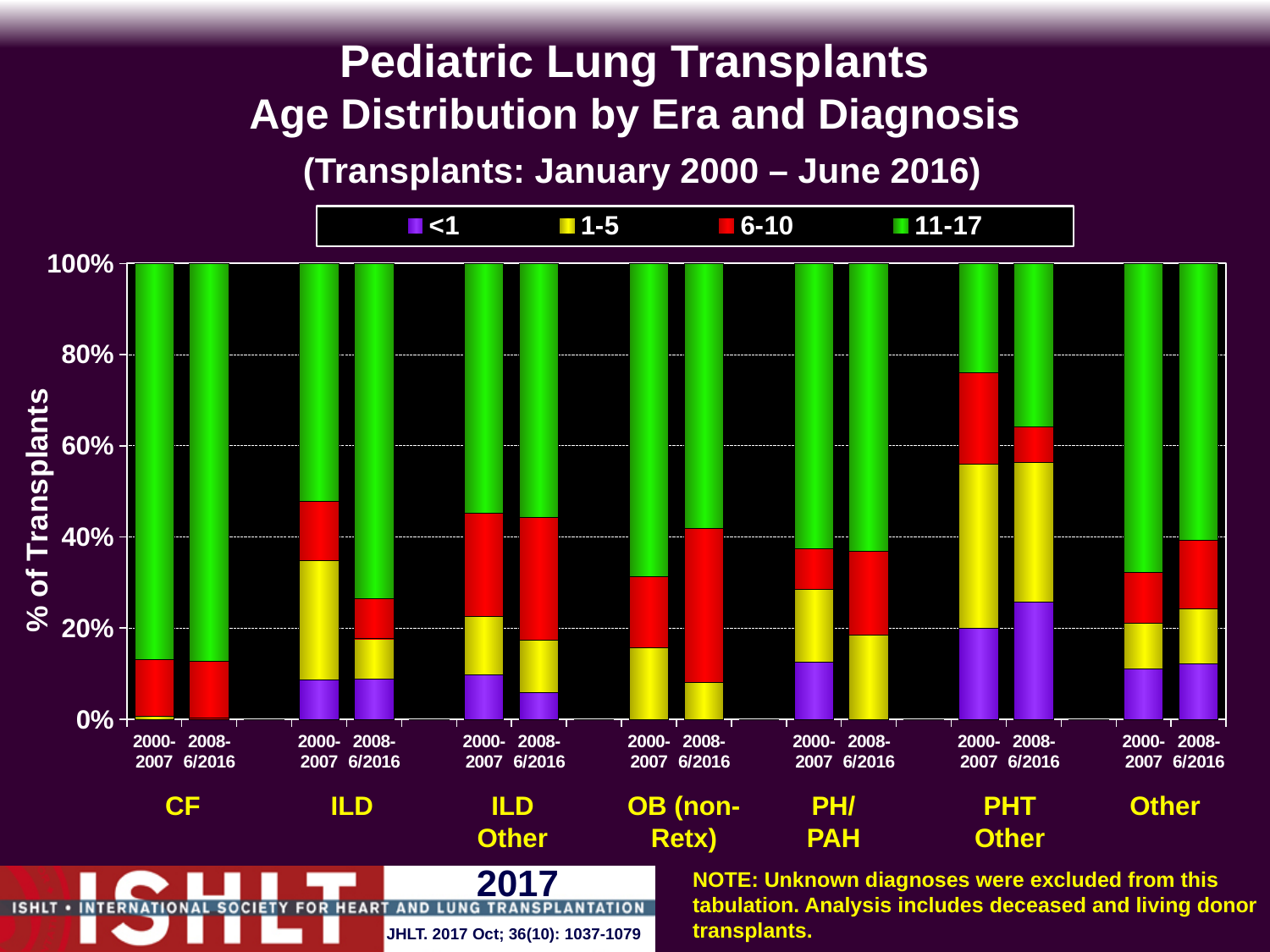
Which diagnosis group has the largest 11-17 share in the 2008-6/2016 era? CF How many age groups does the legend list? 4 What is the label on the y axis? % of Transplants How many bars are plotted in total on the chart? 14 What do the segments of each stacked bar add up to? 100% Which diagnosis group has the smallest 11-17 share in the 2008-6/2016 era? PHT Other What kind of chart is shown on the slide? Stacked bar chart Which has the larger <1 share in 2008-6/2016: CF or PHT Other? PHT Other How many diagnosis groups are shown along the x axis? 7 Is the 11-17 share for CF in 2000-2007 greater or less than 80%? greater Is the 1-5 share for ILD in 2000-2007 greater or less than 20%? greater Is the 11-17 share for PHT Other in 2000-2007 greater or less than 40%? less